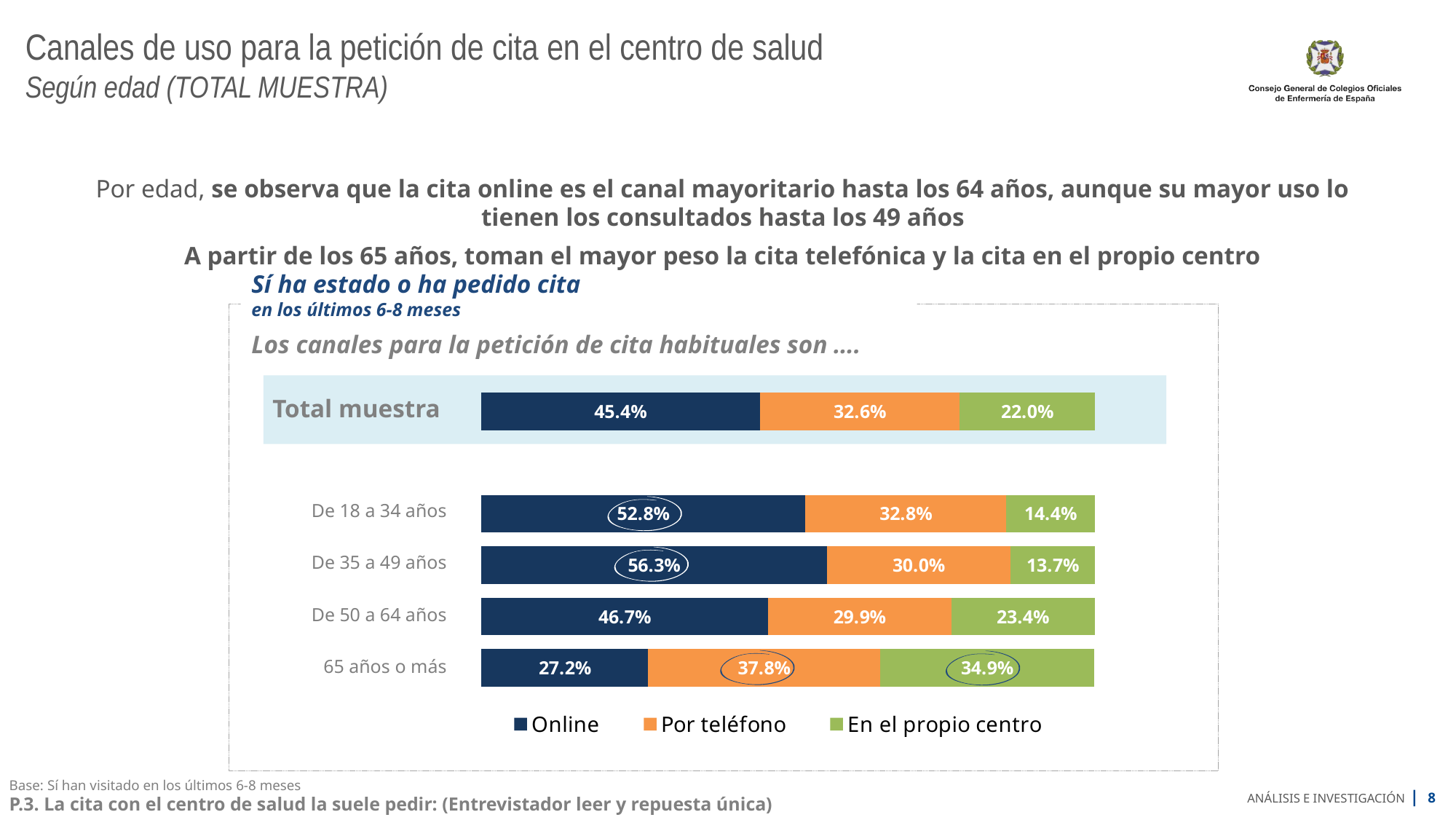
What is the difference between the Online value for 'De 35 a 49 años' and for '65 años o más'? 29.1 percentage points What is the 'En el propio centro' value for 'Total muestra'? 22.0% What percentage of the 'De 18 a 34 años' group uses the Online channel? 52.8% Which colour represents the 'Por teléfono' series in the legend? Orange How many series does the legend list? 3 What is the total of the three segments for the 'De 50 a 64 años' bar? 100.0% What kind of chart is shown on the slide? Stacked bar chart Which age group has the lowest 'En el propio centro' value? De 35 a 49 años What is the 'Por teléfono' value for the '65 años o más' group? 37.8% Which age group has the highest Online value? De 35 a 49 años How many age groups are shown in the chart, excluding 'Total muestra'? 4 For the '65 años o más' group, which is larger: 'Por teléfono' or 'En el propio centro'? Por teléfono